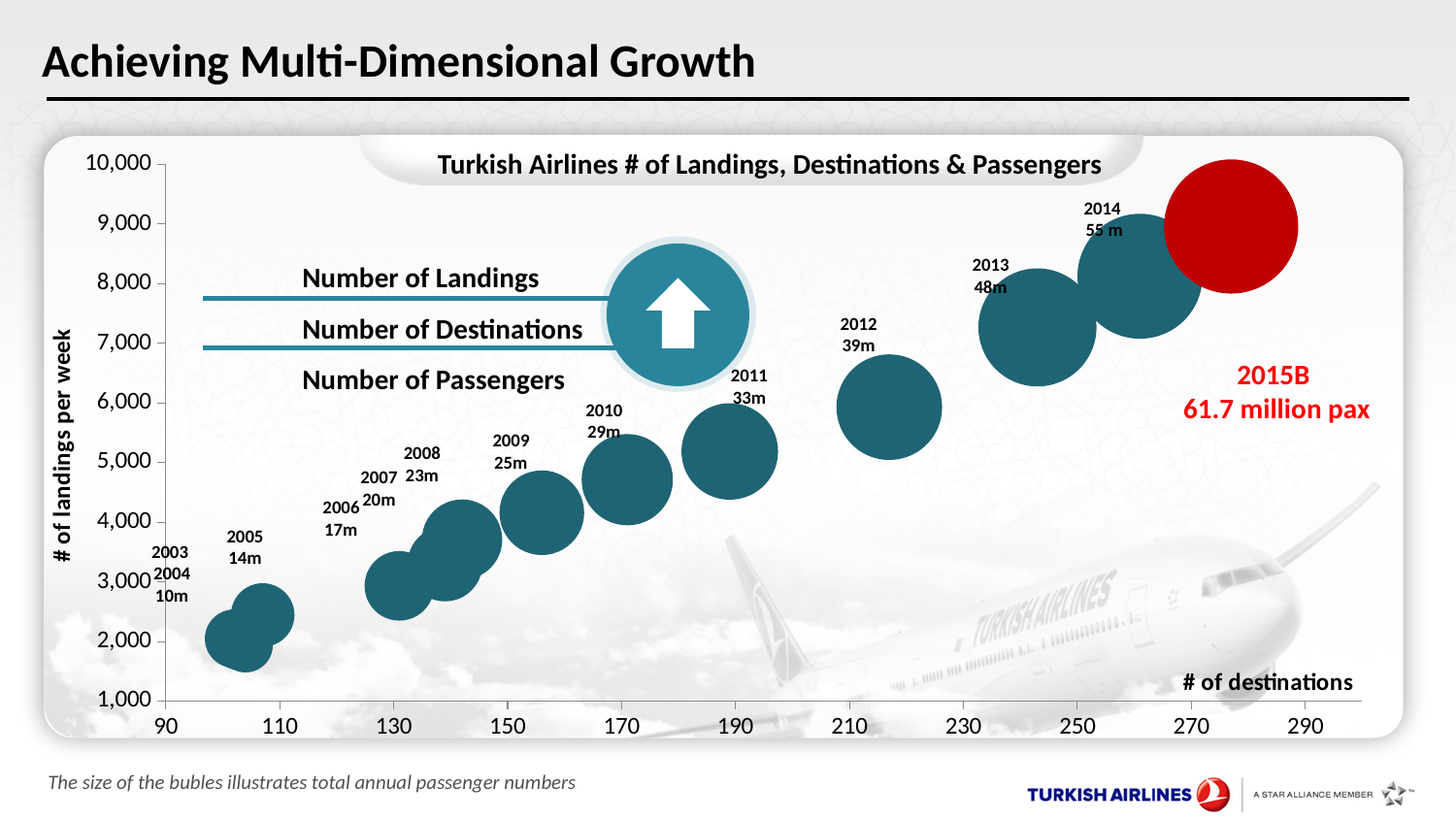
Is the number of landings per week for the 2012 bubble greater or less than 5,000? greater Do the number of landings per week rise or fall as the number of destinations increases along the x axis? rise How many passengers does the 2011 bubble label show? 33m What is the label of the vertical axis? # of landings per week What is the difference between the labelled passenger numbers for 2014 and 2013? 7m What passenger figure is shown for 2015B? 61.7 million pax What passenger number is labelled for 2013? 48m Which year has the highest labelled passenger number? 2015B What is the title of the chart? Turkish Airlines # of Landings, Destinations & Passengers What kind of chart is shown on the slide? Bubble chart Which labelled passenger number is the lowest on the chart? 10m (2003/2004) Which year has more labelled passengers, 2009 or 2012? 2012